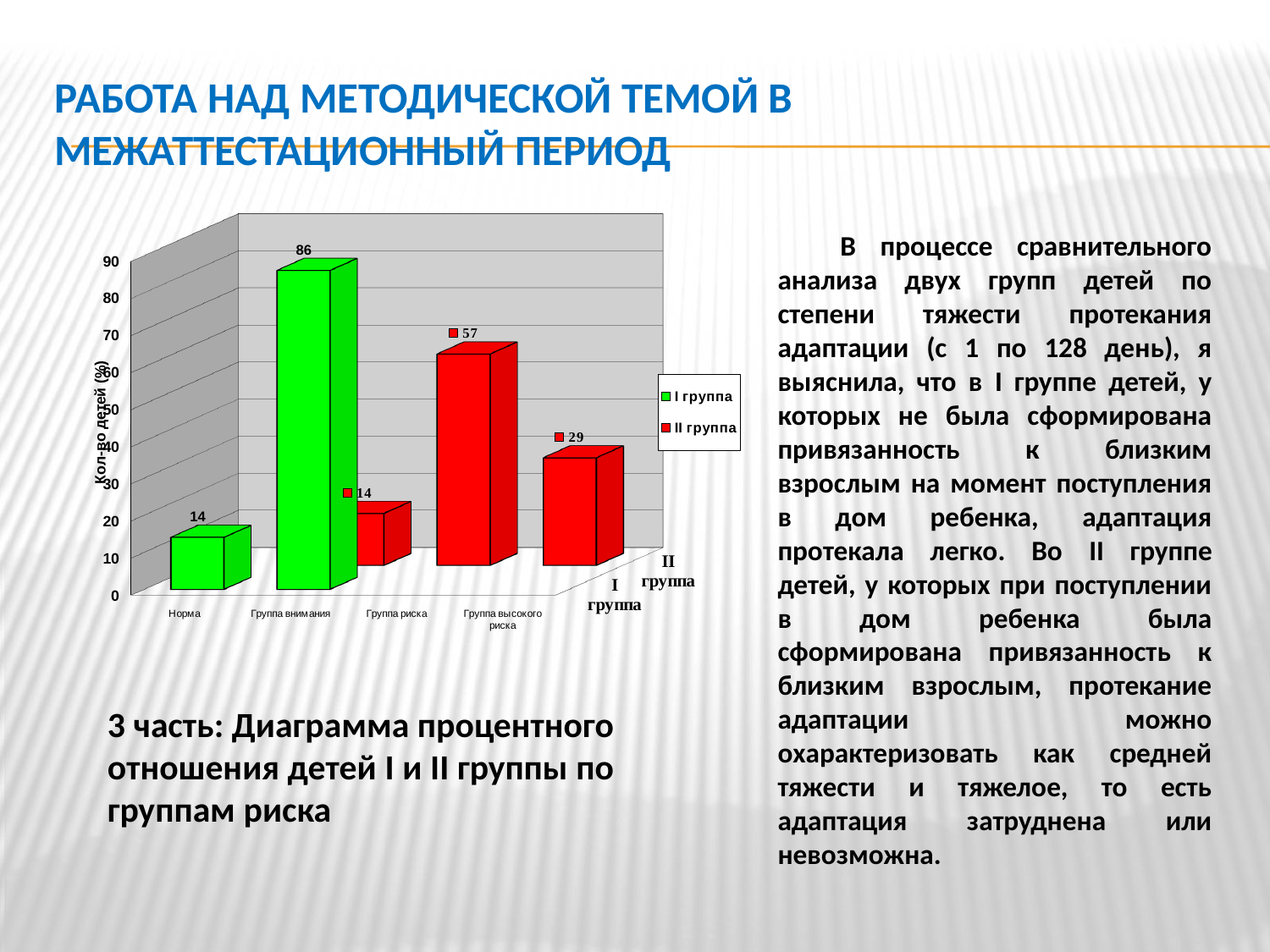
What is the value for Норма in the I группа series? 14 What is the label of the vertical axis of the chart? Кол-во детей (%) Which category has the highest value in the I группа series? Группа внимания What is the difference between the highest I группа value (86) and the highest II группа value (57)? 29 What is the highest value shown for the II группа series? 57 What are the two series named in the chart legend? I группа and II группа What type of chart is shown on the slide? bar chart How many categories are shown on the x axis of the chart? 4 Which is larger: the highest value of I группа or the highest value of II группа? I группа What is the value for Группа внимания in the I группа series? 86 How many series does the chart legend list? 2 What is the lowest value shown for the II группа series? 14